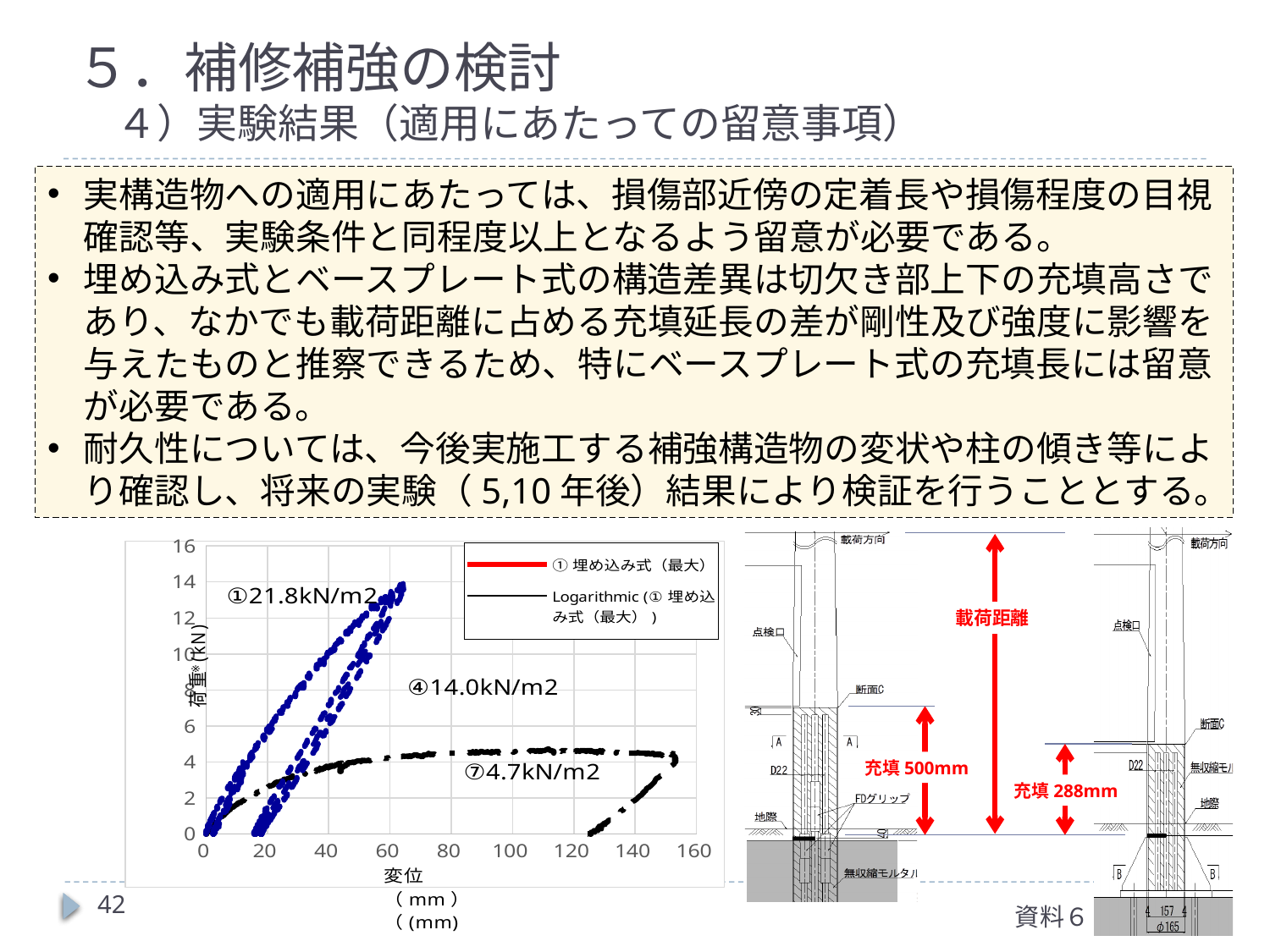
What value is annotated for ⑦ in the load–displacement chart? 4.7kN/m2 What is the label of the x axis of the load–displacement chart? 変位 (mm) In the load–displacement chart, is the peak load of the black dashed curve (⑦) greater or less than 6 kN? less What kind of chart is shown at the bottom left of the slide? scatter chart In the load–displacement chart, which curve reaches a higher peak load, the blue curve (①) or the black dashed curve (⑦)? the blue curve (①) What value is annotated for ④ in the load–displacement chart? 14.0kN/m2 What is the highest tick value shown on the y axis of the load–displacement chart? 16 In the load–displacement chart, is the peak load of the blue curve (①) greater or less than 12 kN? greater What value is annotated next to the curve labelled ① in the load–displacement chart? 21.8kN/m2 What is the highest tick value shown on the x axis of the load–displacement chart? 160 In the load–displacement chart, does the load of the blue curve (①) rise or fall as displacement increases from 0 to about 60 mm? rise How many entries does the legend of the load–displacement chart list? 2